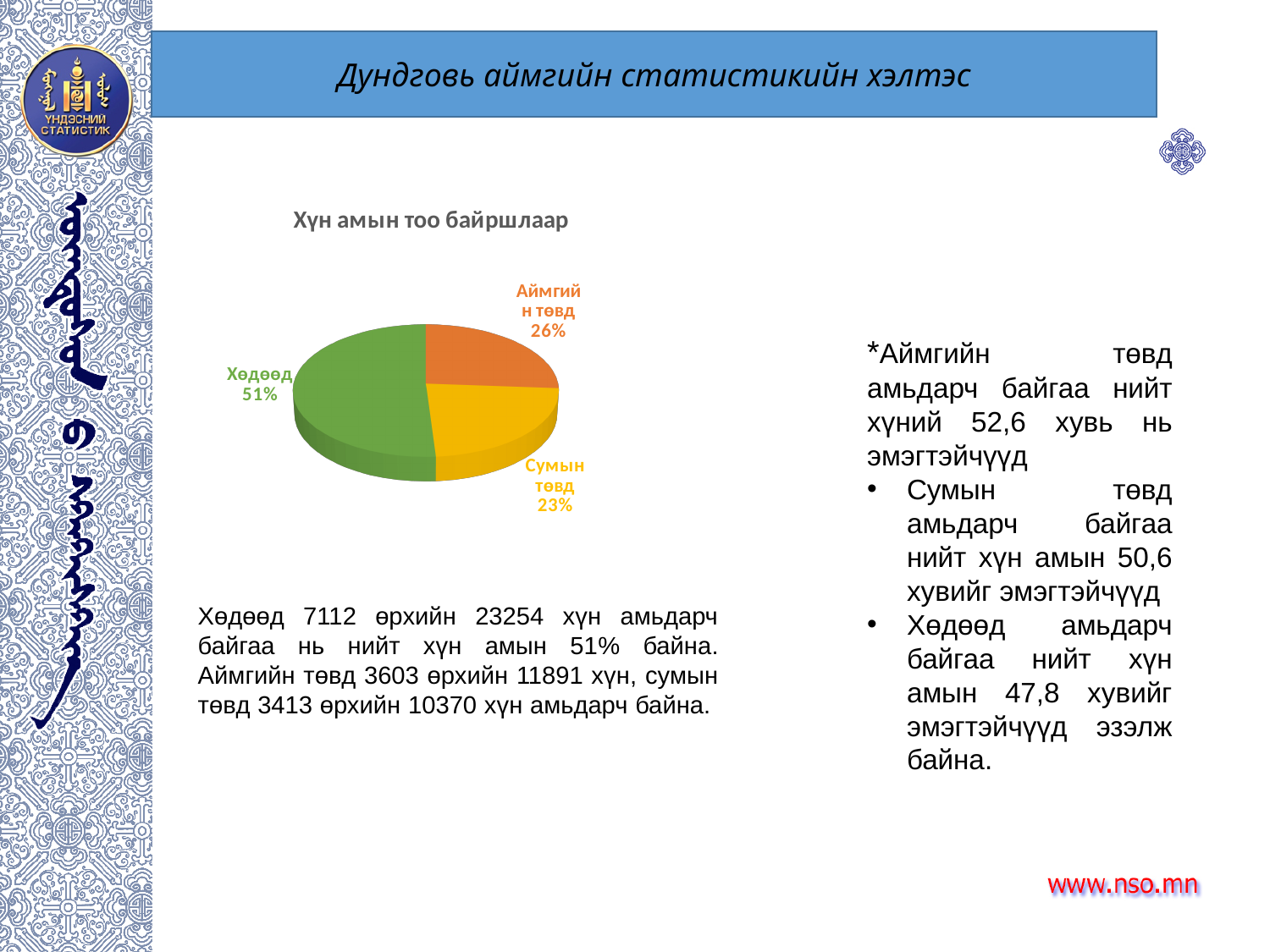
Which category has the largest share of the pie? Хөдөөд What is the title of the chart? Хүн амын тоо байршлаар What share of the pie does Хөдөөд have? 51% What kind of chart is shown on the slide? pie chart Which is larger, the share for Аймгийн төвд or the share for Сумын төвд? Аймгийн төвд What share of the pie does Аймгийн төвд have? 26% How many slices does the pie chart have? 3 What is the difference in percentage points between the Аймгийн төвд share and the Сумын төвд share? 3 What share of the pie does Сумын төвд have? 23% What is the difference in percentage points between the Хөдөөд share and the Аймгийн төвд share? 25 Which category has the smallest share of the pie? Сумын төвд What colour is the Хөдөөд slice of the pie? green